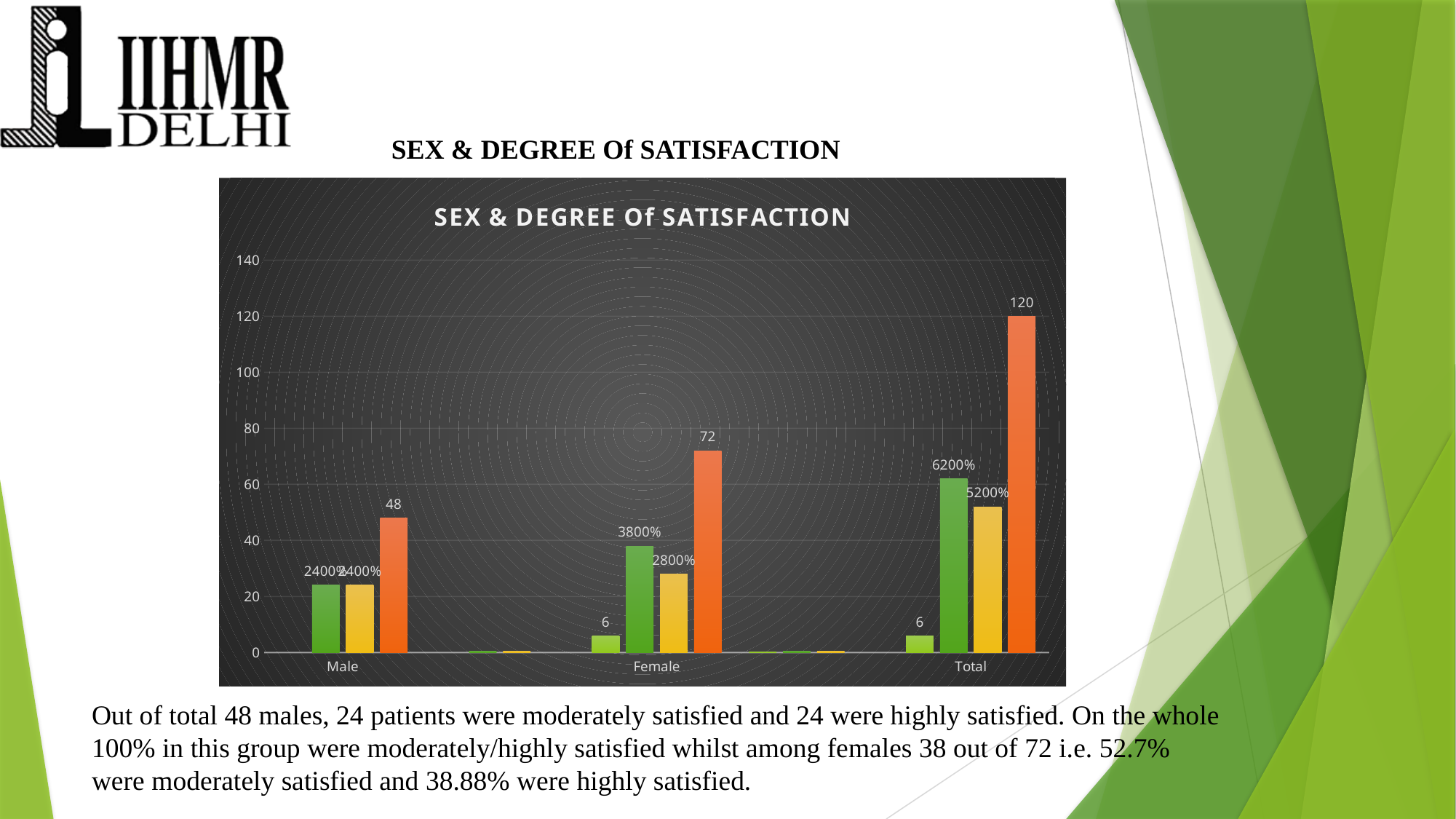
How many categories are shown on the x axis of the chart? 3 What label is shown on the green bar for Female? 3800% Which category has the tallest orange bar? Total Which has the larger orange bar value, Male or Female? Female What label is shown on the yellow bar for Total? 5200% What is the title of the chart? SEX & DEGREE Of SATISFACTION What kind of chart is shown on the slide? bar chart What is the value labelled on the orange bar for Total? 120 What is the difference between the orange bar values for Total and Female? 48 What is the value labelled on the orange bar for Male? 48 What is the value labelled on the orange bar for Female? 72 Do the orange bar values rise or fall from Male to Female to Total? rise